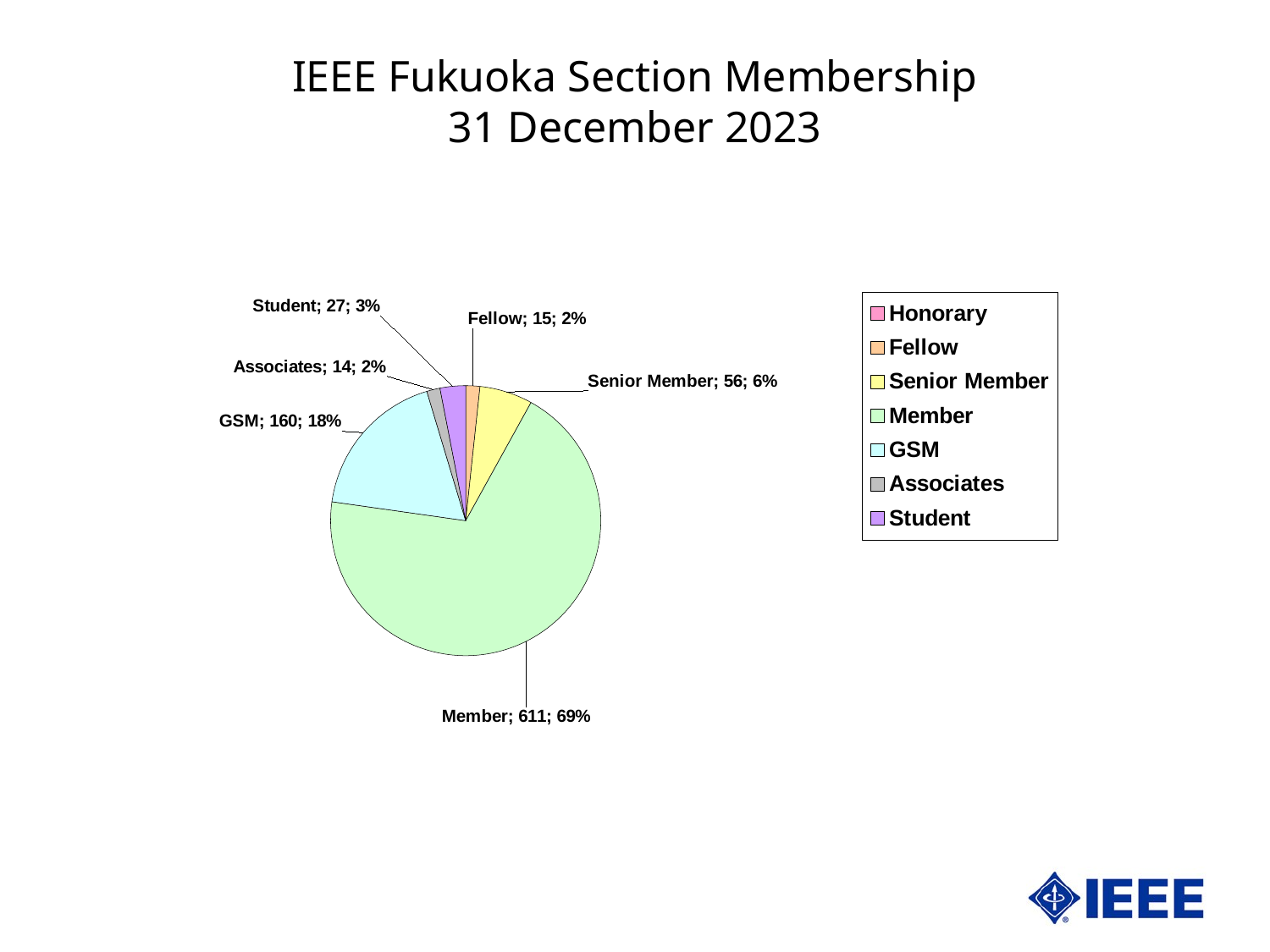
What is the value for Senior Member? 56 Which category has the largest slice of the pie? Member What is the value for GSM? 160 What kind of chart is shown on the slide? pie chart What is the title of the slide containing the chart? IEEE Fukuoka Section Membership 31 December 2023 What share of the pie does the Member slice represent? 69% How many members are in the Member category? 611 Which labelled category has the smallest value? Associates What is the difference between the Member value and the GSM value? 451 What share of the pie does the GSM slice represent? 18% Which is larger, the value for Student or the value for Associates? Student How many entries does the legend list? 7